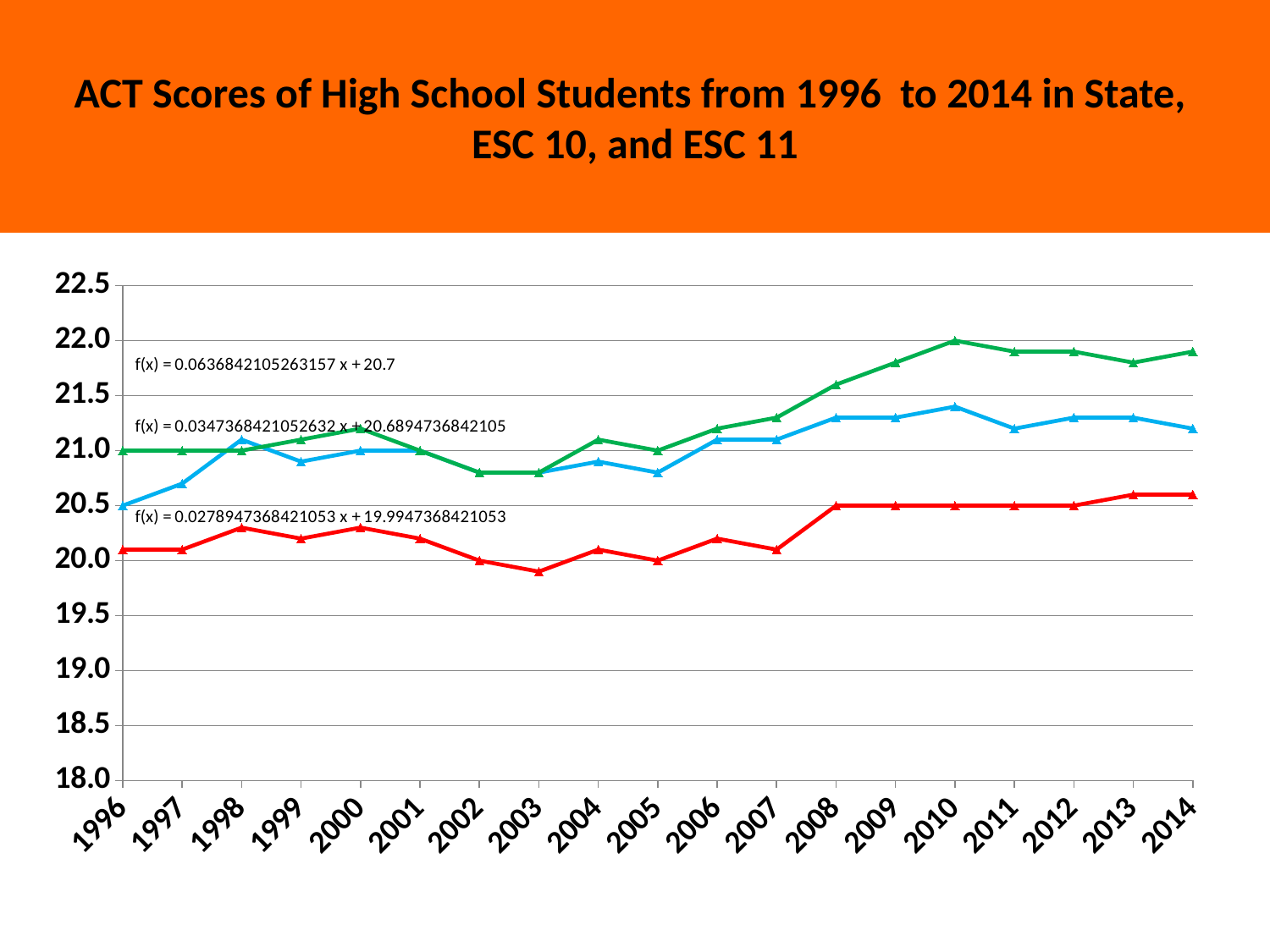
Is the value of the blue line in 2014 greater or less than 21.0? greater Does the green line generally rise or fall from 1996 to 2014? rise In which year does the red line reach its lowest value? 2003 How many trend-line equations (f(x) = ...) are printed on the chart? 3 Is the value of the green line in 2014 greater or less than 21.5? greater What is the title of the chart? ACT Scores of High School Students from 1996 to 2014 in State, ESC 10, and ESC 11 What kind of chart is shown on the slide? line chart How many years are plotted along the x axis? 19 In which year does the green line reach its highest value? 2010 In 2014, which line has the larger value, the green line or the red line? green line What is the value of the green line in 2010? 22.0 Is the value of the red line in 2003 greater or less than 20.0? less